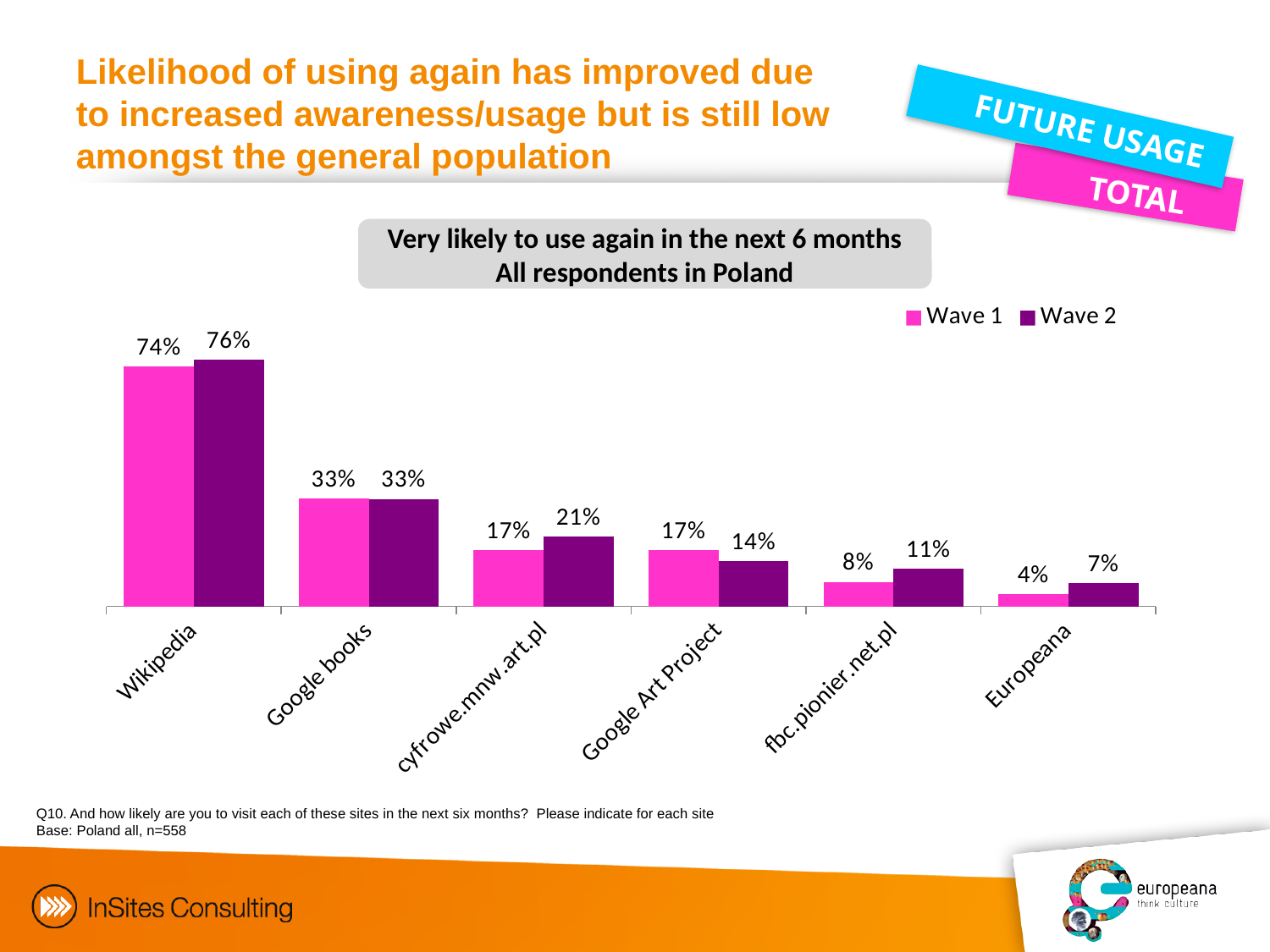
Which site has the highest Wave 1 value? Wikipedia Which site has the lowest Wave 2 value? Europeana What is the Wave 2 value for Wikipedia? 76% How many series does the legend list? 2 For Google Art Project, which is larger: the Wave 1 value or the Wave 2 value? Wave 1 What is the Wave 1 value for cyfrowe.mnw.art.pl? 17% What is the difference between the Wave 2 and Wave 1 values for cyfrowe.mnw.art.pl? 4 percentage points What is the title of the chart? Very likely to use again in the next 6 months All respondents in Poland How many sites are shown on the x axis? 6 What kind of chart is shown on the slide? Bar chart Do the Wave 2 values rise or fall from Wikipedia to Europeana along the x axis? Fall What is the Wave 2 value for Europeana? 7%